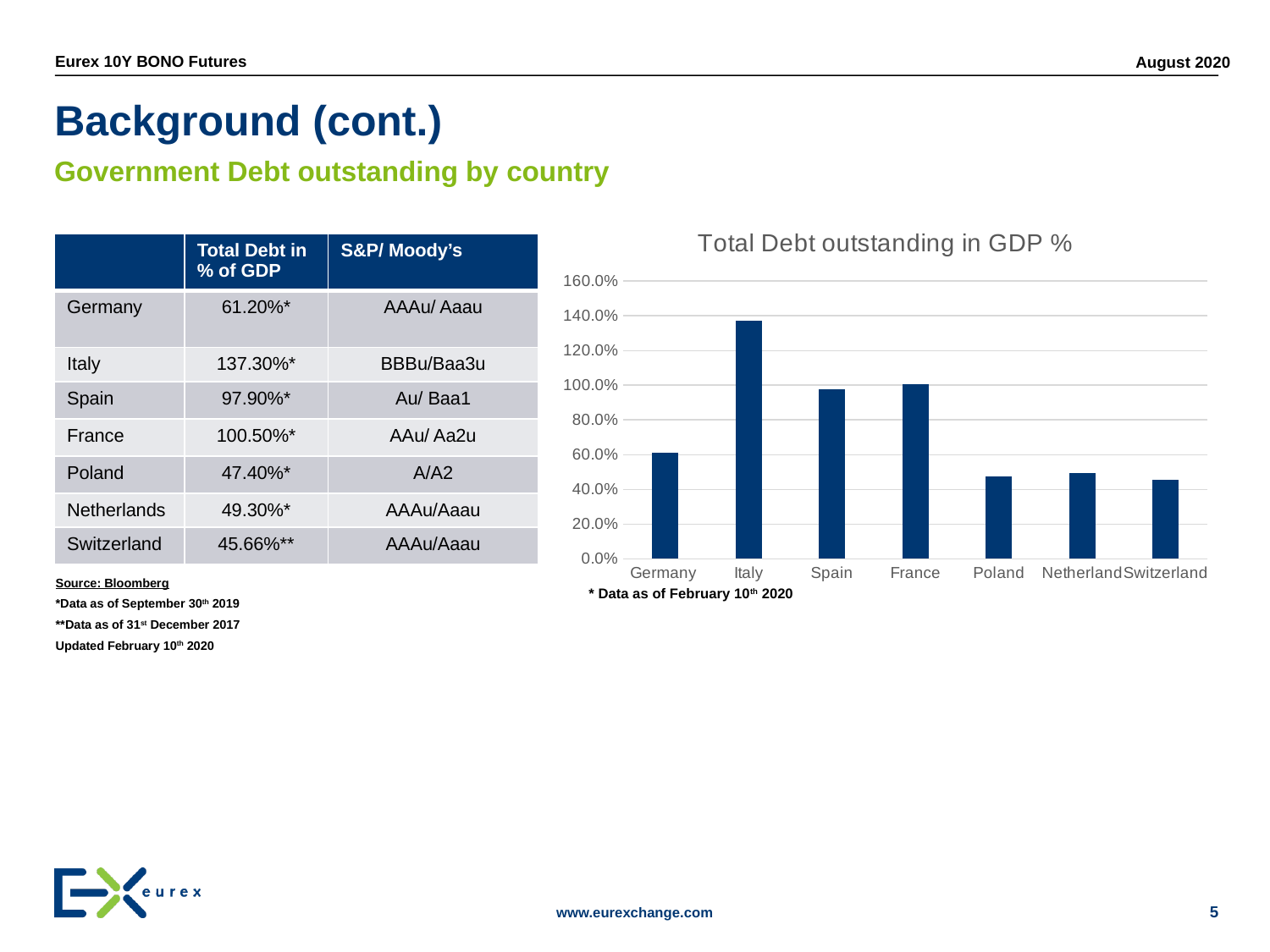
Is the value for Spain in the chart greater or less than 80.0%? greater According to the slide, what is Germany's total debt in % of GDP? 61.20% Is the value for Italy in the chart greater or less than 120.0%? greater What is the title of the chart? Total Debt outstanding in GDP % According to the slide, what is Italy's total debt in % of GDP? 137.30% Is the value for Poland in the chart greater or less than 60.0%? less What type of chart is shown on the slide? bar chart Which country has the highest total debt outstanding in GDP % in the chart? Italy Which has the larger total debt outstanding in GDP %, Italy or France? Italy Which has the larger total debt outstanding in GDP %, Germany or Spain? Spain How many countries are plotted in the chart? 7 Which country has the lowest total debt outstanding in GDP % in the chart? Switzerland